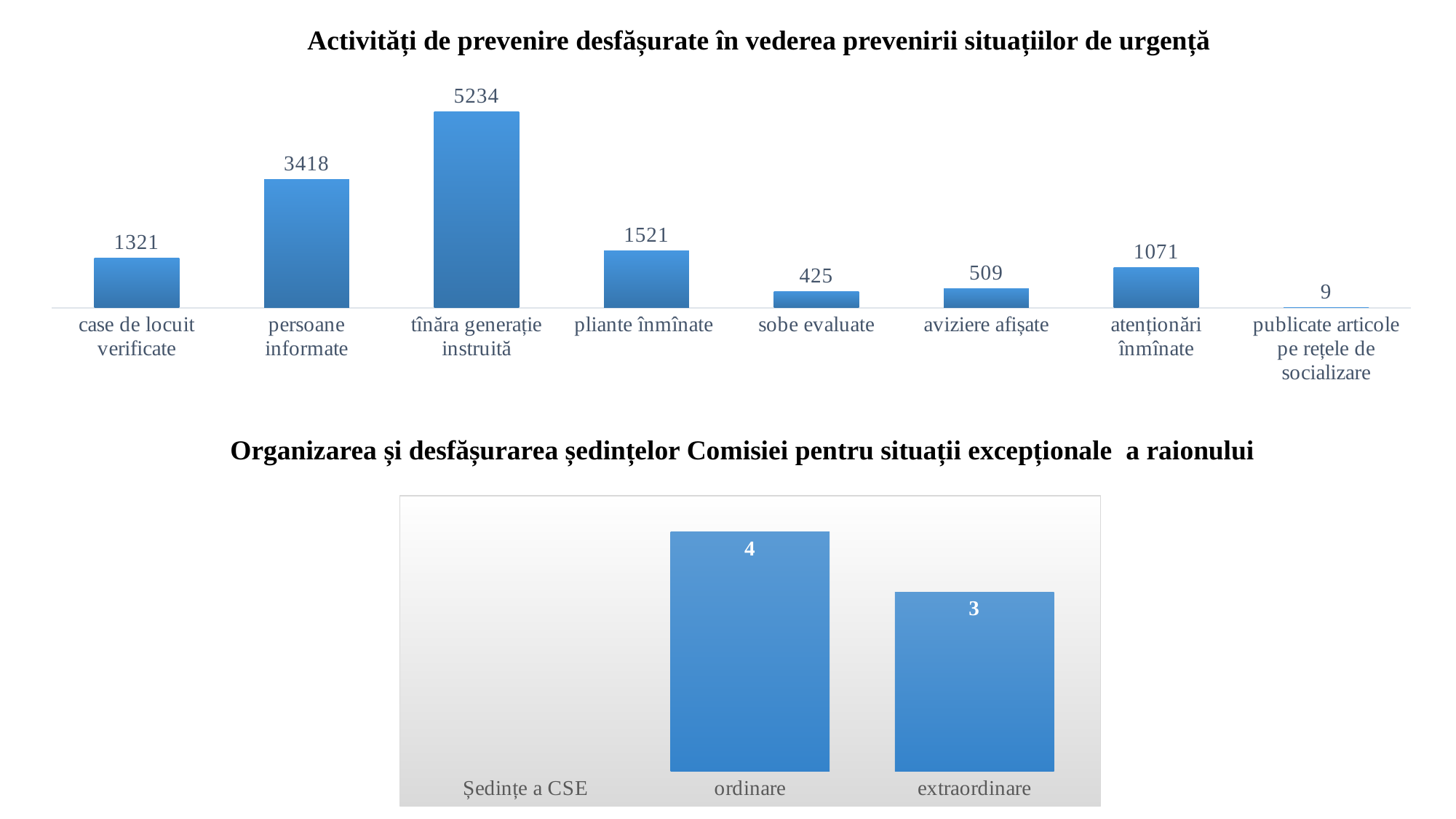
What is the title of the bottom chart? Organizarea și desfășurarea ședințelor Comisiei pentru situații excepționale a raionului In the top chart, which is larger: 'pliante înmînate' or 'atenționări înmînate'? pliante înmînate In the top chart, which category has the highest value? tînăra generație instruită In the top chart, which category has the lowest value? publicate articole pe rețele de socializare In the top chart, what is the difference between 'persoane informate' and 'case de locuit verificate'? 2097 How many categories are shown in the top chart? 8 In the top chart, what is the value for 'tînăra generație instruită'? 5234 In the bottom chart, what is the difference between 'ordinare' and 'extraordinare'? 1 In the top chart, what is the value for 'publicate articole pe rețele de socializare'? 9 In the bottom chart, what is the value for 'ordinare'? 4 In the top chart, what is the value for 'sobe evaluate'? 425 What type of chart is the top chart? bar chart